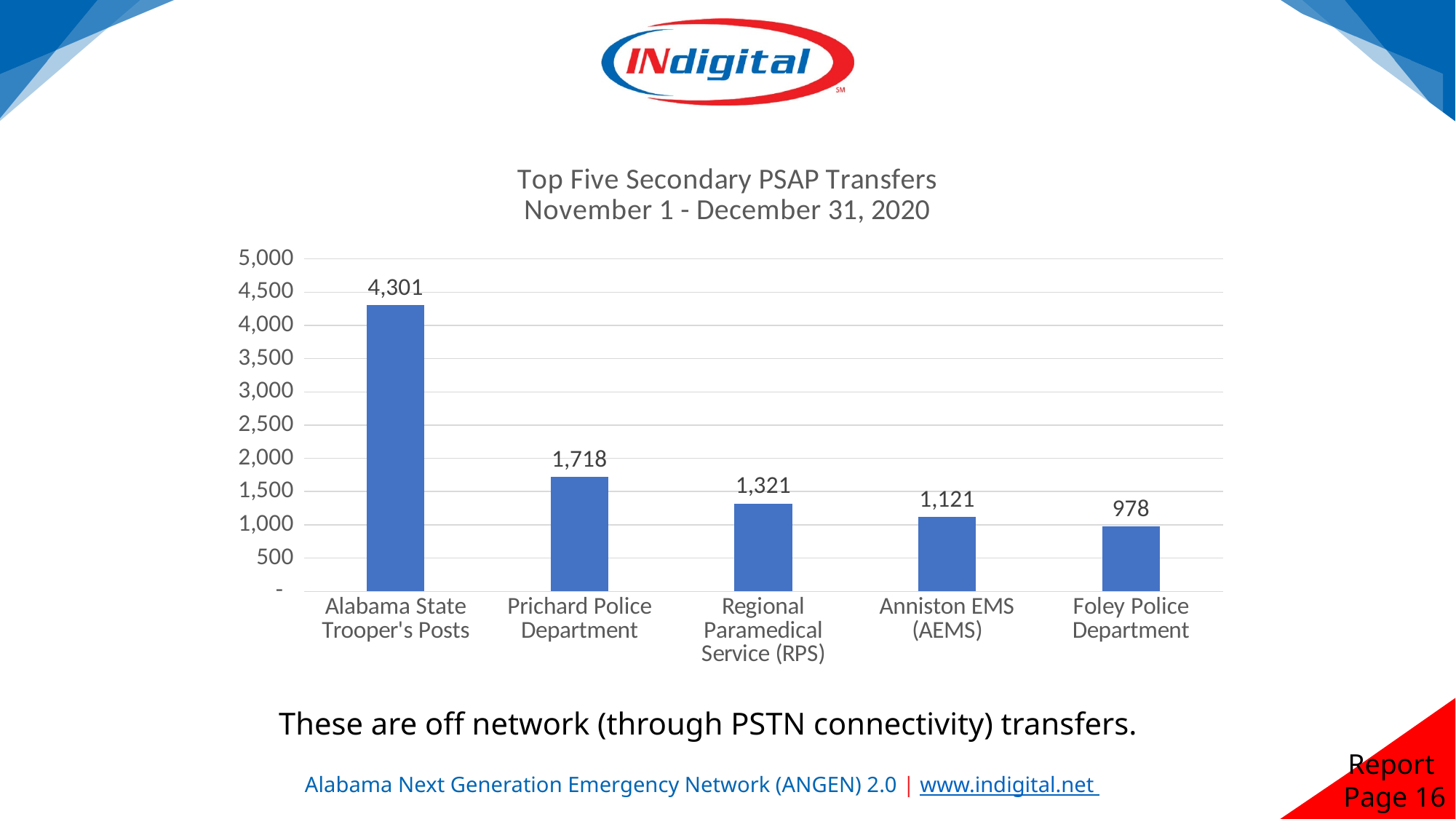
What is the value for Regional Paramedical Service (RPS)? 1,321 What is the value for Foley Police Department? 978 Which is larger, the value for Regional Paramedical Service (RPS) or Anniston EMS (AEMS)? Regional Paramedical Service (RPS) What is the title of the chart? Top Five Secondary PSAP Transfers November 1 - December 31, 2020 What kind of chart is shown on the slide? Bar chart What is the value for Alabama State Trooper's Posts? 4,301 What is the difference between the values for Alabama State Trooper's Posts and Prichard Police Department? 2,583 Which category has the lowest value? Foley Police Department How many categories are shown in the chart? 5 Which category has the highest value? Alabama State Trooper's Posts What is the difference between the values for Anniston EMS (AEMS) and Foley Police Department? 143 What is the value for Prichard Police Department? 1,718